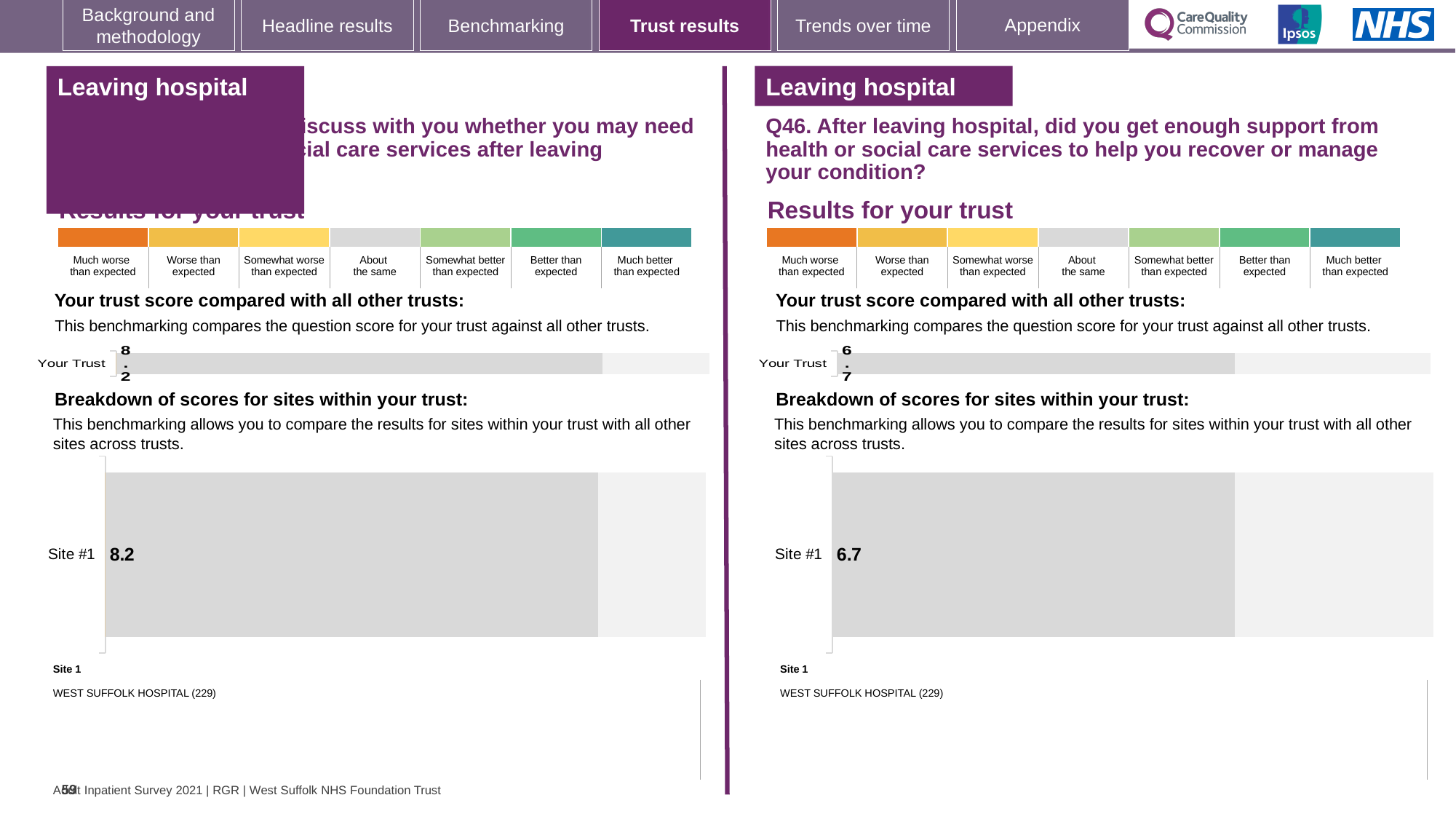
On the left half of the slide, what is the score shown for Your Trust? 8.2 Which is larger: the Your Trust score on the left half of the slide or the Your Trust score on the right half (Q46)? Left (8.2) How many sites are shown in the right-hand site breakdown chart (Q46)? 1 In the right-hand site breakdown chart (Q46), what is the score for Site #1? 6.7 On the right half of the slide (Q46), what is the score shown for Your Trust? 6.7 In the left-hand site breakdown chart, what is the score for Site #1? 8.2 What type of chart is used to show the Your Trust score on the left half of the slide? Bar chart What is the difference between the Site #1 score on the left half of the slide and the Site #1 score on the right half (Q46)? 1.5 How many categories are shown in the colour scale legend above the right-hand Results for your trust section? 7 Which hospital is listed as Site 1 in the right-hand site breakdown (Q46)? WEST SUFFOLK HOSPITAL (229) What type of chart is used to show the Site #1 score on the right half of the slide? Bar chart How many sites are shown in the left-hand site breakdown chart? 1